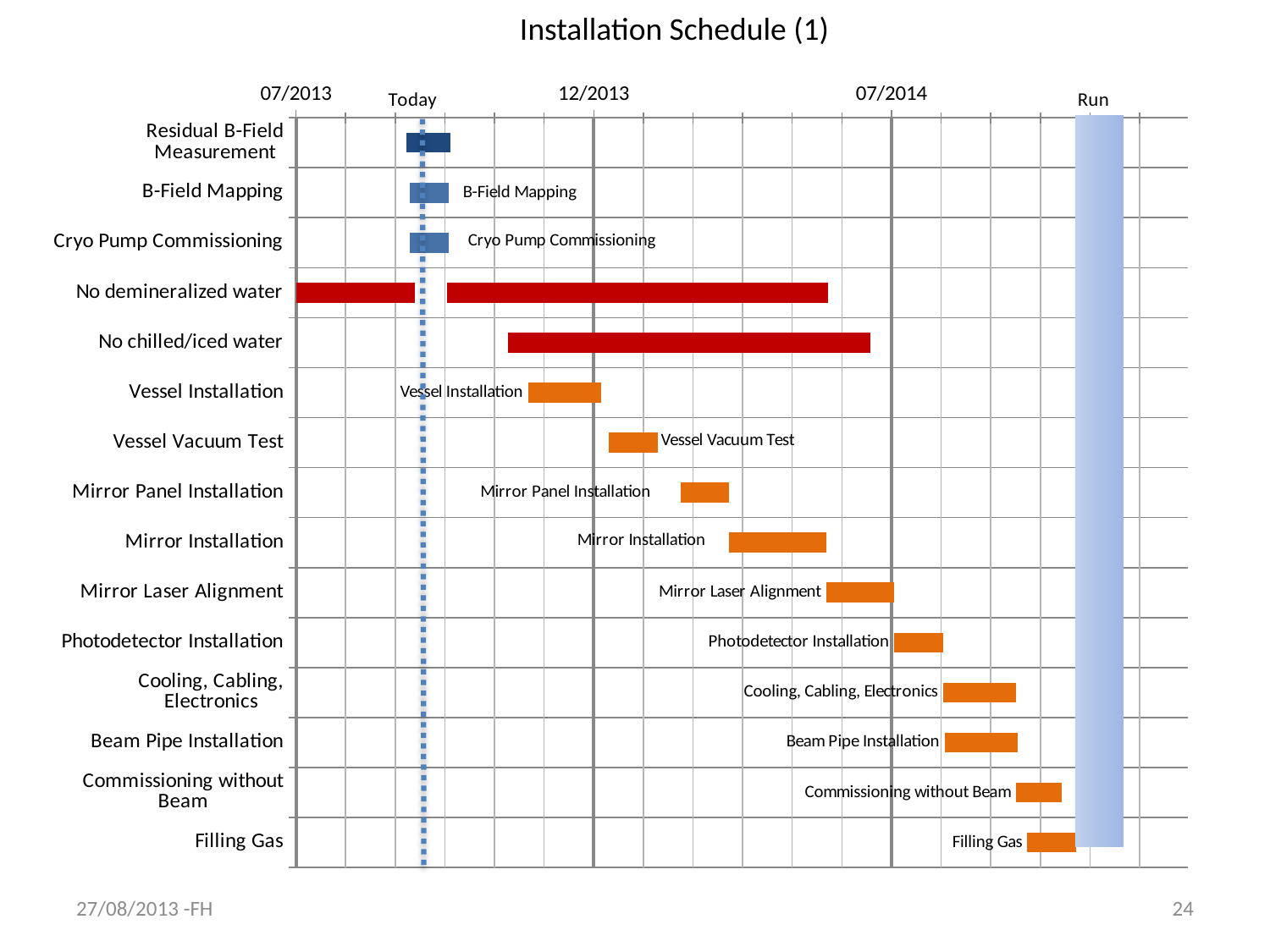
Which task's bar starts earliest, at 07/2013? No demineralized water What is the title of the chart? Installation Schedule (1) Which task has the longest bar in the chart? No demineralized water Does the Vessel Vacuum Test bar start before or after 12/2013? after What kind of chart is shown on the slide? Gantt chart (horizontal bar chart) Which bar is longer, No chilled/iced water or Vessel Vacuum Test? No chilled/iced water Which task is scheduled last, immediately before the 'Run' period? Filling Gas Does the Vessel Installation bar start before or after 12/2013? before How many tasks (rows) are listed on the vertical axis of the chart? 15 How many tasks are drawn with red bars? 2 Which starts later, Mirror Installation or Mirror Panel Installation? Mirror Installation